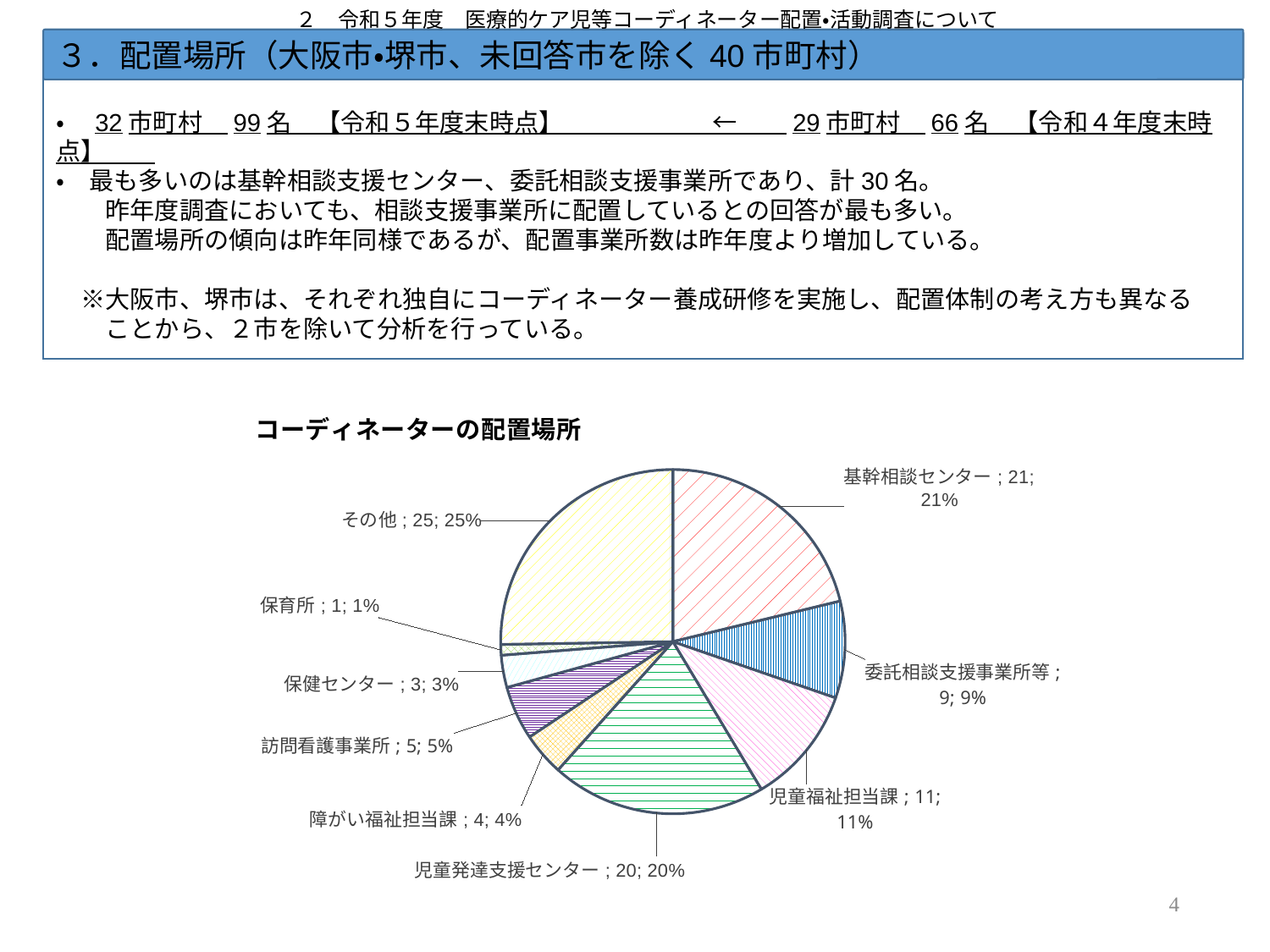
What is the title of the chart? コーディネーターの配置場所 What kind of chart is shown on the slide? pie chart What share of the pie does 委託相談支援事業所等 represent? 9% What is the value for 訪問看護事業所 in the pie chart? 5 Which category has the largest slice in the pie chart? その他 What is the value for 基幹相談センター in the pie chart? 21 What share of the pie does 児童福祉担当課 represent? 11% Which category has the smallest slice in the pie chart? 保育所 Which is larger, the value for 保健センター or the value for 障がい福祉担当課? 障がい福祉担当課 What is the difference between the values for 基幹相談センター and 委託相談支援事業所等? 12 How many slices does the pie chart have? 9 What is the value for 児童発達支援センター in the pie chart? 20